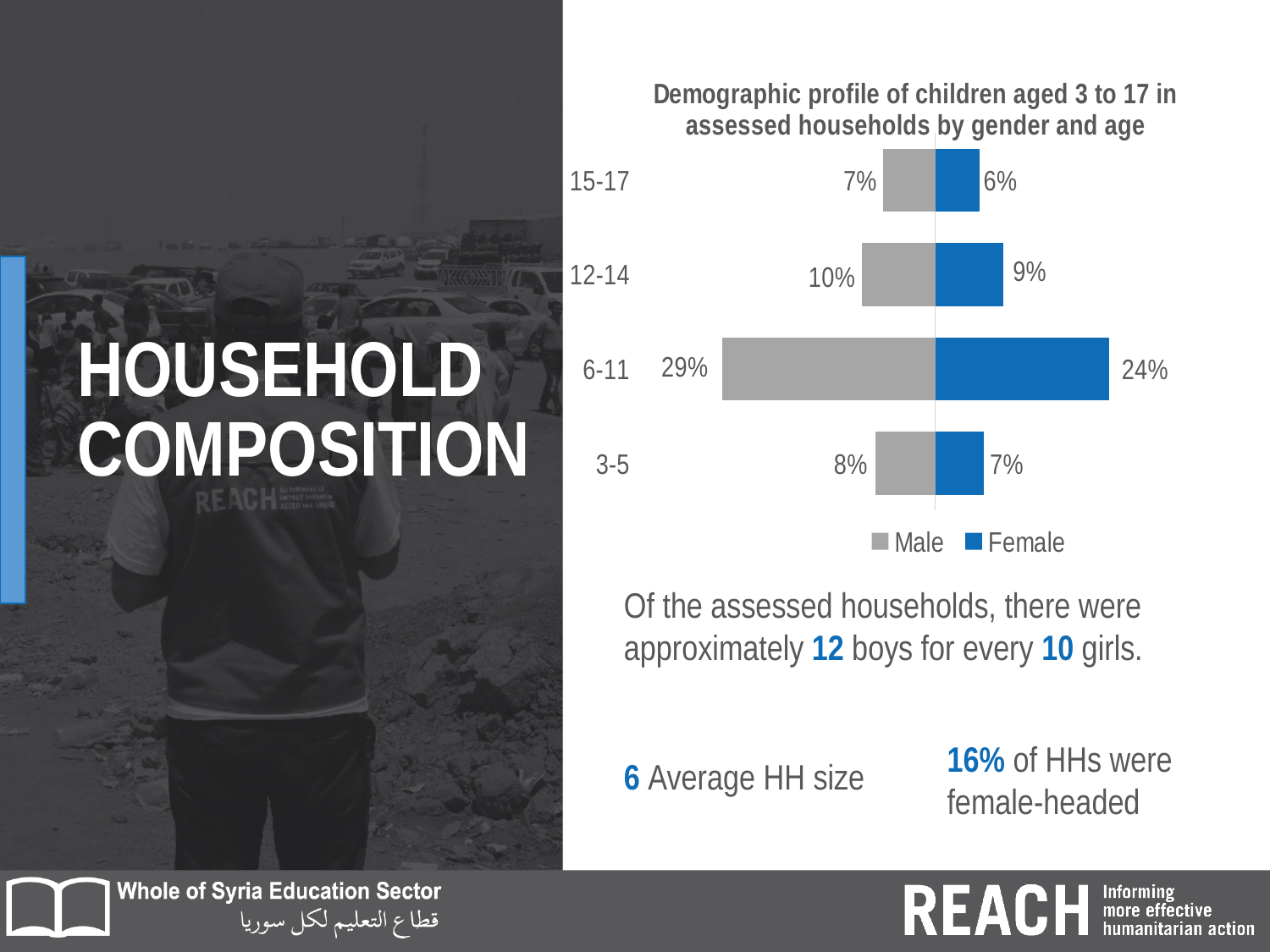
What is the Female value for the 3-5 age group? 7% Which age group has the highest Female value? 6-11 What is the Male value for the 15-17 age group? 7% How many series does the legend list? 2 What is the Female value for the 12-14 age group? 9% What is the title of the chart? Demographic profile of children aged 3 to 17 in assessed households by gender and age What is the difference between the Male and Female values for the 6-11 age group? 5% How many age groups are shown in the chart? 4 What kind of chart is shown on the slide? Bar chart Which is larger, the Male value for 12-14 or the Male value for 3-5? Male value for 12-14 Which age group has the lowest Male value? 15-17 What is the Male value for the 6-11 age group? 29%